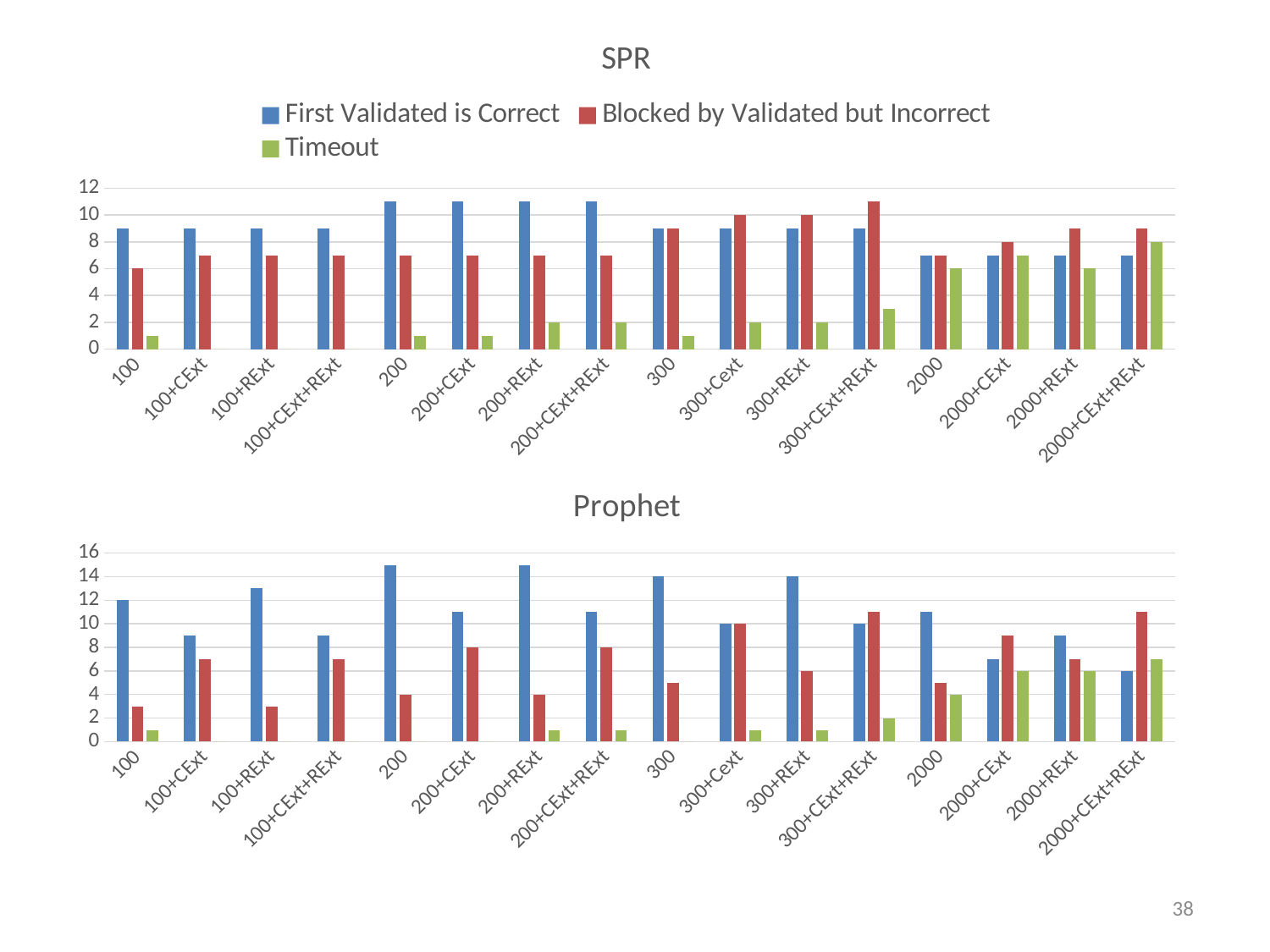
In the Prophet chart, which category has the highest Timeout value? 2000+CExt+RExt In the Prophet chart, what is the value of First Validated is Correct for the 100 category? 12 How many categories are shown on the x axis of the SPR chart? 16 In the Prophet chart, what is the value of First Validated is Correct for the 300 category? 14 In the Prophet chart, for 2000+CExt+RExt, which is larger: First Validated is Correct or Blocked by Validated but Incorrect? Blocked by Validated but Incorrect In the SPR chart, is the First Validated is Correct value for 200 greater or less than 10? greater In the SPR chart, what is the value of Blocked by Validated but Incorrect for the 100 category? 6 In the SPR chart, what is the Timeout value for 2000+CExt+RExt? 8 In the SPR chart, which category has the highest Blocked by Validated but Incorrect value? 300+CExt+RExt How many series does the legend of the SPR chart list? 3 In the Prophet chart, is the First Validated is Correct value for 200 greater or less than 14? greater In the Prophet chart, what is the difference between the First Validated is Correct values for 300 and 100? 2